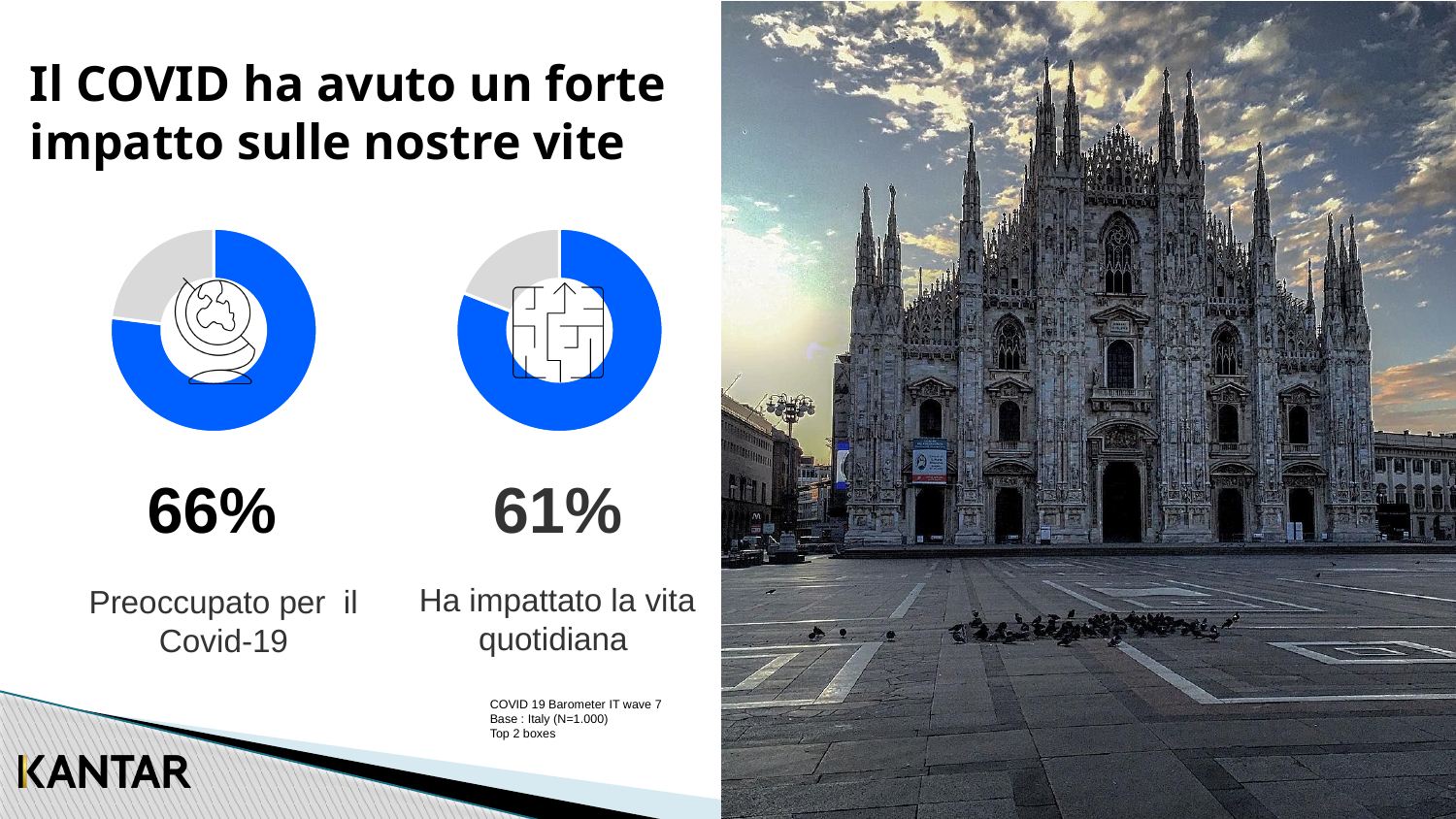
What is the difference in percentage points between the 'Preoccupato per il Covid-19' chart and the 'Ha impattato la vita quotidiana' chart? 5 percentage points What is the title of the slide containing the two donut charts? Il COVID ha avuto un forte impatto sulle nostre vite What kind of chart is used to show the 66% and 61% values on the slide? Donut (pie) chart What percentage is shown for the left chart, 'Preoccupato per il Covid-19'? 66% Which chart shows the lowest percentage on the slide? Ha impattato la vita quotidiana Which of the two charts shows the higher percentage, 'Preoccupato per il Covid-19' or 'Ha impattato la vita quotidiana'? Preoccupato per il Covid-19 What colour is used for the highlighted (filled) portion of both donut charts? Blue How many charts are shown on the slide? 2 What percentage is shown for the right chart, 'Ha impattato la vita quotidiana'? 61%